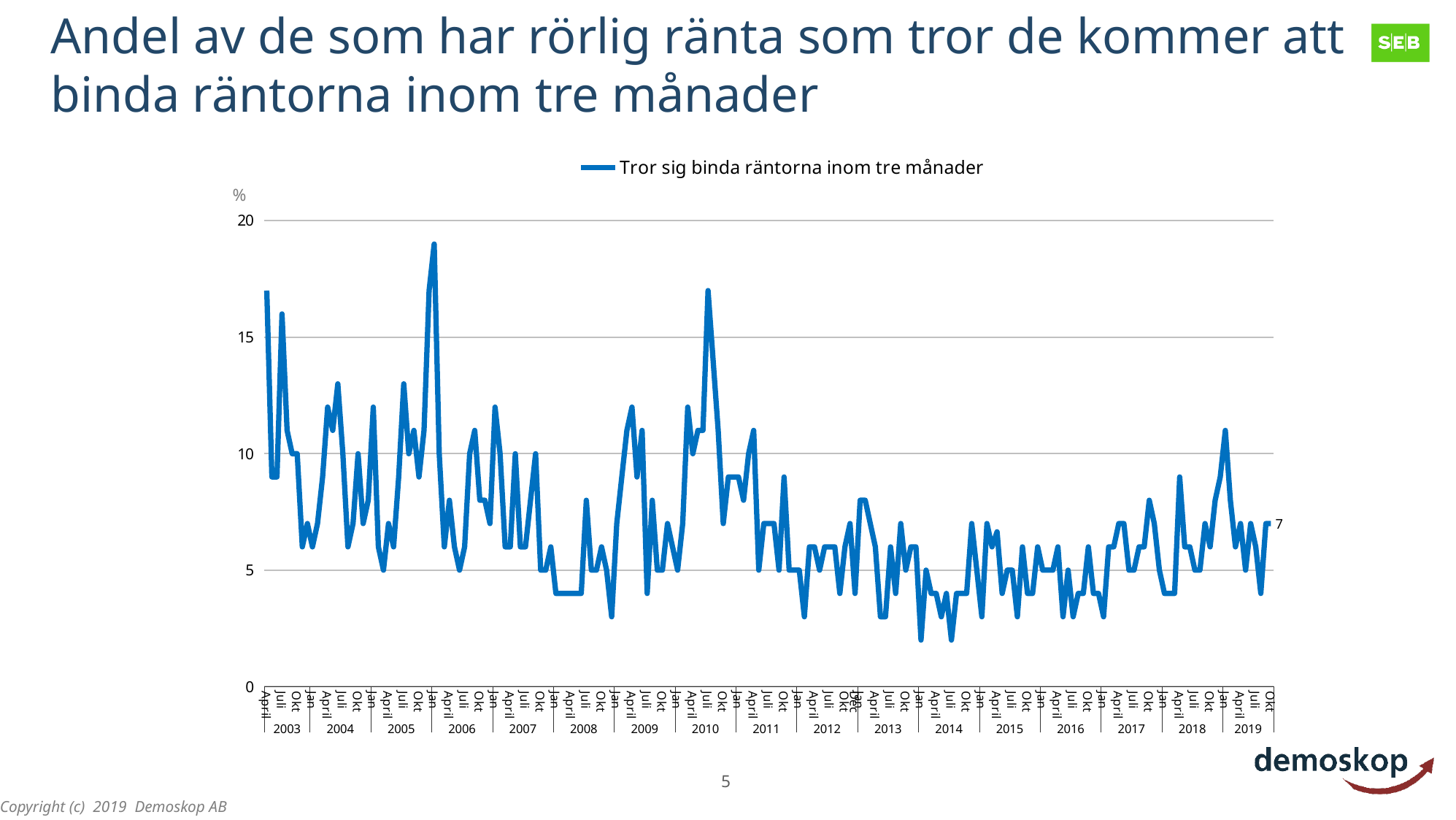
Overall, does the line rise or fall from 2003 to 2019? fall Which is higher: the peak in 2006 or the peak in 2010? the peak in 2006 How many series does the legend list? 1 Is the peak value in early 2006 greater or less than 15? greater What is the name of the series shown in the legend? Tror sig binda räntorna inom tre månader In which year does the line reach its highest peak? 2006 What is the value of the last data point (Okt 2019)? 7 What kind of chart is shown on the slide? line chart Is the peak value in mid-2010 greater or less than 15? greater How many years are labelled on the x axis? 17 Is the value around Jan 2014 greater or less than 5? less What unit is shown on the vertical axis? %